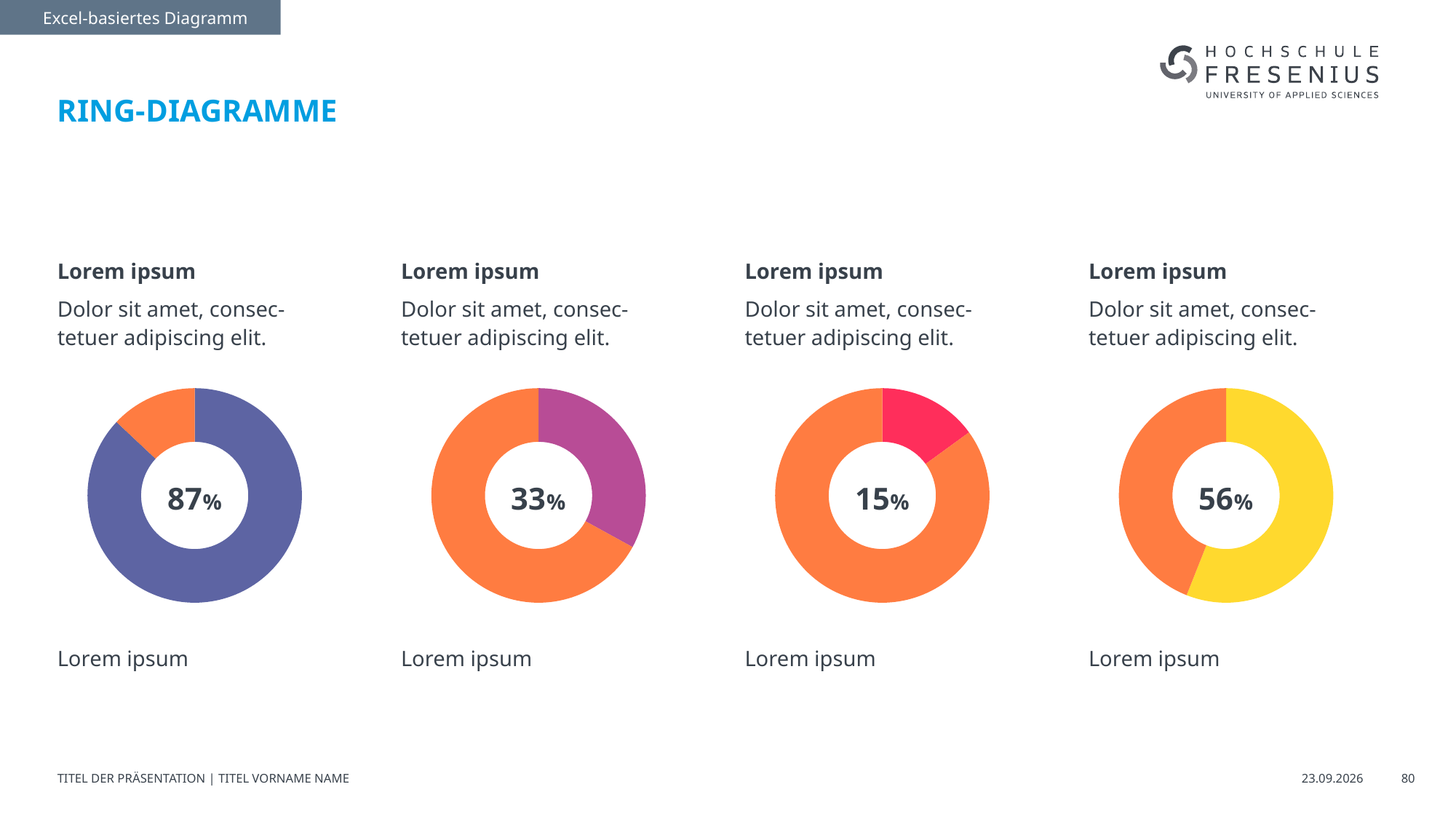
Which of the four ring charts shows the lowest percentage? The third chart from the left (15%) Which is larger: the percentage in the second ring chart from the left or the percentage in the rightmost ring chart? The rightmost chart (56%) How many ring charts are shown on the slide? 4 What is the difference between the percentages shown in the second and third ring charts from the left? 18% Which of the four ring charts shows the highest percentage? The leftmost chart (87%) What is the difference between the percentage in the leftmost ring chart and the percentage in the rightmost ring chart? 31% What is the title of the slide containing the ring charts? RING-DIAGRAMME What percentage is shown in the centre of the third ring chart from the left? 15% What percentage is shown in the centre of the rightmost ring chart? 56% What percentage is shown in the centre of the leftmost ring chart? 87% What kind of chart is used on this slide? Ring (doughnut) chart What percentage is shown in the centre of the second ring chart from the left? 33%